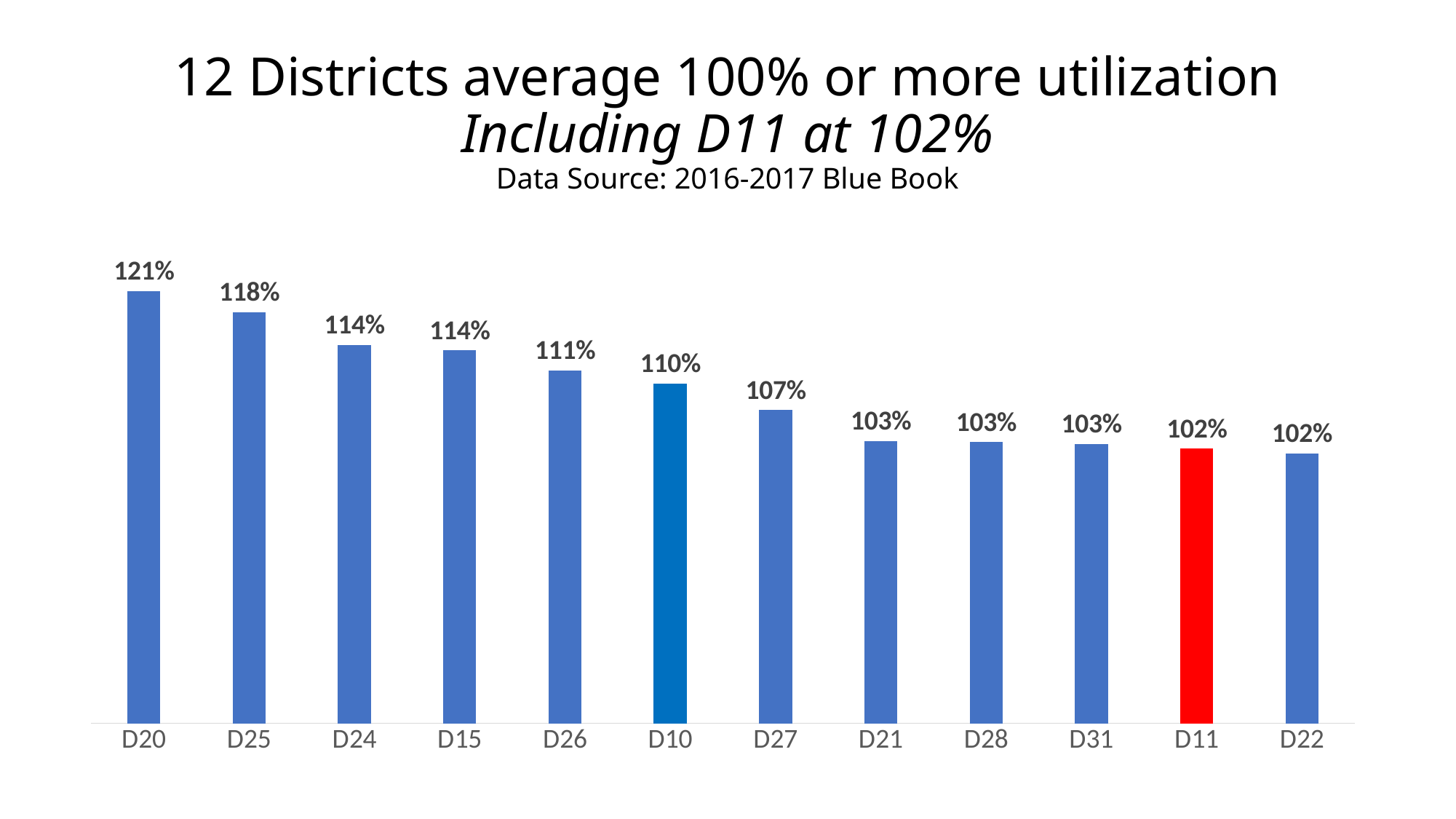
How many districts are shown in the chart? 12 What is the difference between the utilization of D26 and D11? 9% Which district's bar is coloured red? D11 What kind of chart is shown on the slide? Bar chart What is the utilization value for D20? 121% Which has a higher utilization, D25 or D15? D25 Which district has the highest utilization? D20 What is the utilization value for D10? 110% Which has a higher utilization, D27 or D21? D27 What is the utilization value for D11? 102% What is the utilization value for D27? 107% What is the difference between the utilization of D20 and D25? 3%